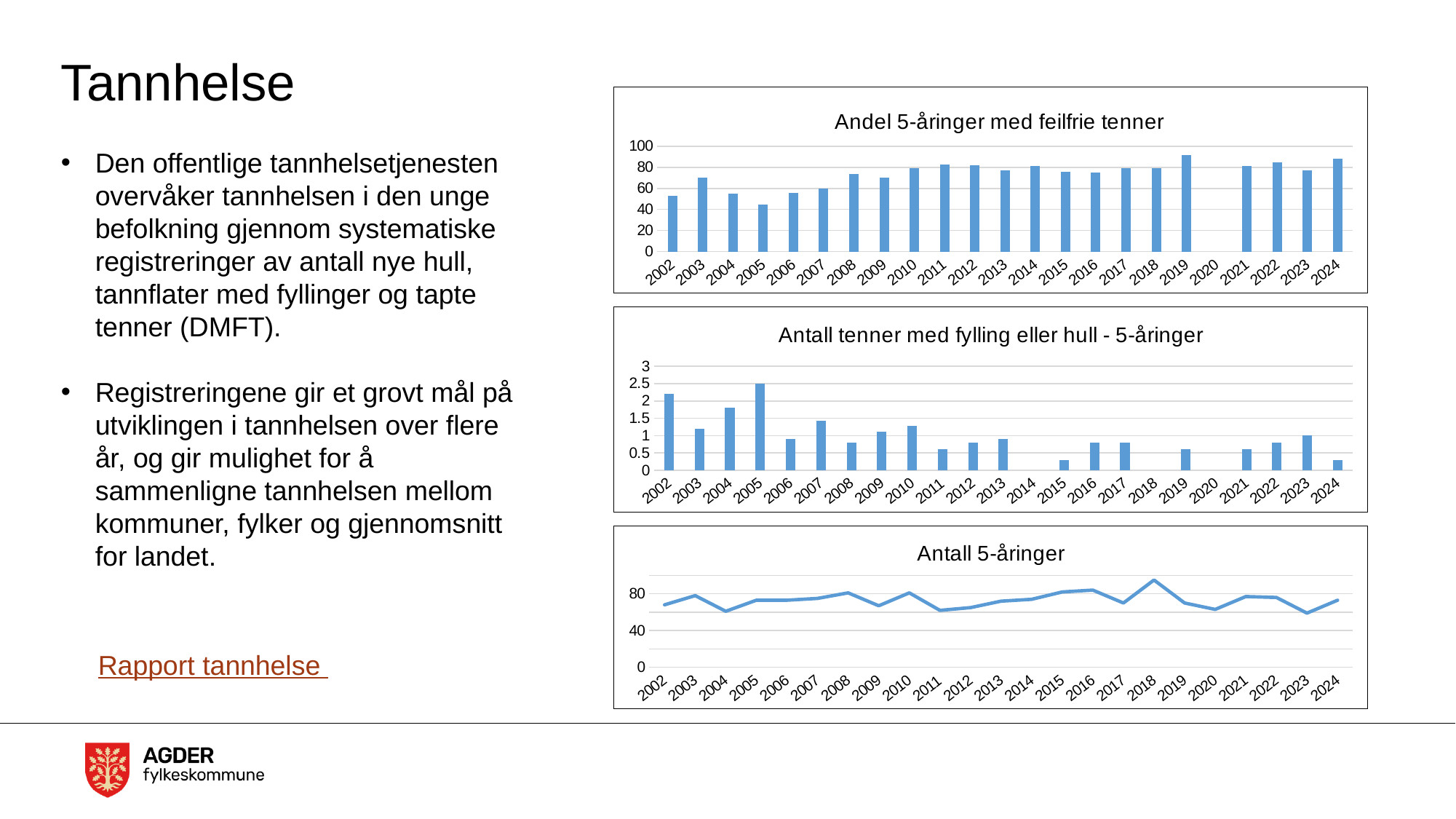
What kind of chart is the bottom chart, 'Antall 5-åringer'? line chart In the middle chart 'Antall tenner med fylling eller hull - 5-åringer', is the value for 2011 greater or less than 1? less In the middle chart 'Antall tenner med fylling eller hull - 5-åringer', is the value for 2002 greater or less than 2? greater In the top chart 'Andel 5-åringer med feilfrie tenner', is the value for 2019 greater or less than 80? greater In the top chart 'Andel 5-åringer med feilfrie tenner', which year has the lowest value? 2005 In the top chart 'Andel 5-åringer med feilfrie tenner', which year has the highest value? 2019 In the middle chart 'Antall tenner med fylling eller hull - 5-åringer', which year has the highest value? 2005 In the bottom chart 'Antall 5-åringer', which year has the highest value? 2018 How many year labels are shown on the x axis of the top chart 'Andel 5-åringer med feilfrie tenner'? 23 What kind of chart is the top chart, 'Andel 5-åringer med feilfrie tenner'? bar chart In the top chart 'Andel 5-åringer med feilfrie tenner', which is larger, the value for 2003 or the value for 2005? 2003